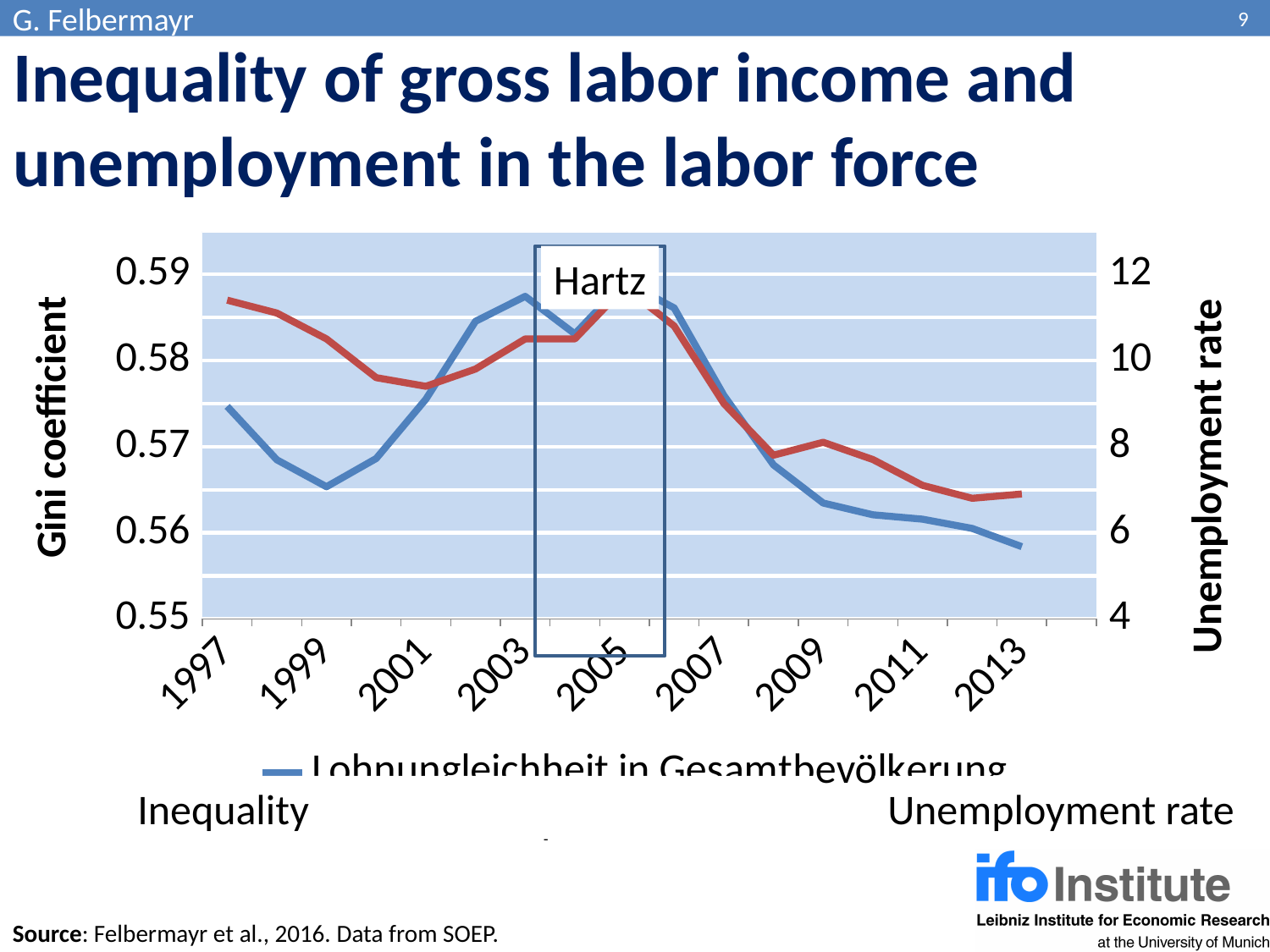
How many data series are plotted on the chart? 2 Is the Unemployment rate for 2001 greater or less than 10? less Is the Unemployment rate for 2013 greater or less than 8? less Which year has the higher Unemployment rate, 1997 or 2013? 1997 Is the Gini coefficient (Inequality) for 1999 greater or less than 0.57? less How many year labels are shown on the x axis? 9 Does the Inequality (Gini coefficient) line rise or fall between 2007 and 2013? fall What label is shown in the annotation box over the 2004–2006 period of the chart? Hartz What kind of chart is shown on the slide? line chart Does the Unemployment rate line rise or fall between 1999 and 2001? fall